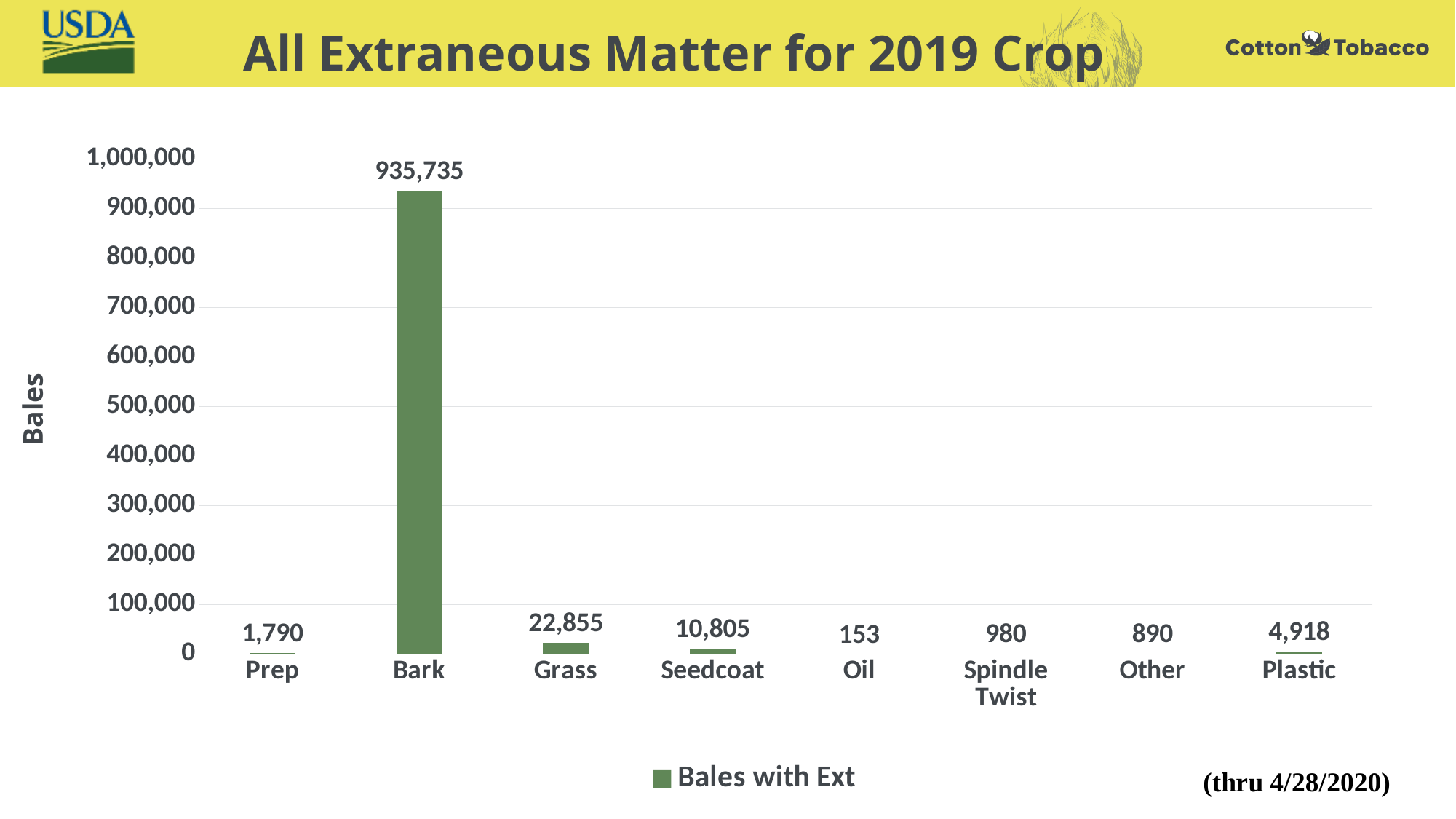
What is the value for Seedcoat? 10,805 What is the difference between the values for Grass and Seedcoat? 12,050 What is the value for Bark? 935,735 How many categories are shown on the x axis? 8 What is the value for Oil? 153 Which category has the lowest value? Oil What is the value for Grass? 22,855 Which is larger, the value for Plastic or the value for Prep? Plastic Which category has the highest value? Bark Is the value for Bark greater or less than 900,000? greater What series name does the legend show? Bales with Ext What kind of chart is shown on the slide? bar chart